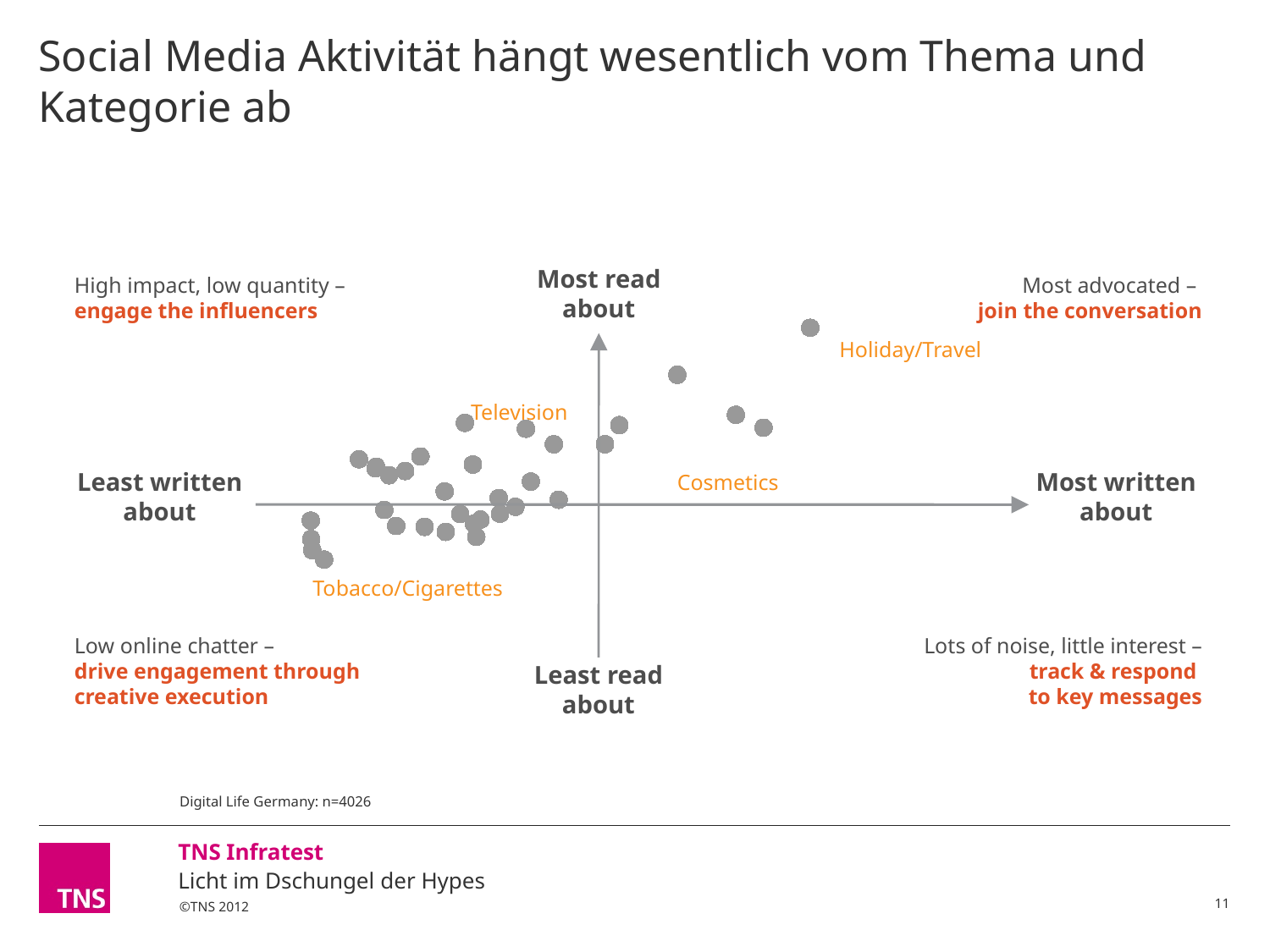
Which is more written about, Holiday/Travel or Tobacco/Cigarettes? Holiday/Travel Is Tobacco/Cigarettes above or below the horizontal axis (least read about / most read about)? Below Which is more written about, Cosmetics or Television? Cosmetics In which quadrant of the chart does Holiday/Travel appear? Most advocated – join the conversation Which labelled category is the most written about? Holiday/Travel Which labelled category is the least read about? Tobacco/Cigarettes What kind of chart is shown on the slide? Scatter chart How many categories are labelled by name on the chart? 4 Which labelled category is the most read about? Holiday/Travel Which labelled category is the least written about? Tobacco/Cigarettes What does the horizontal axis of the chart run from and to? Least written about to Most written about